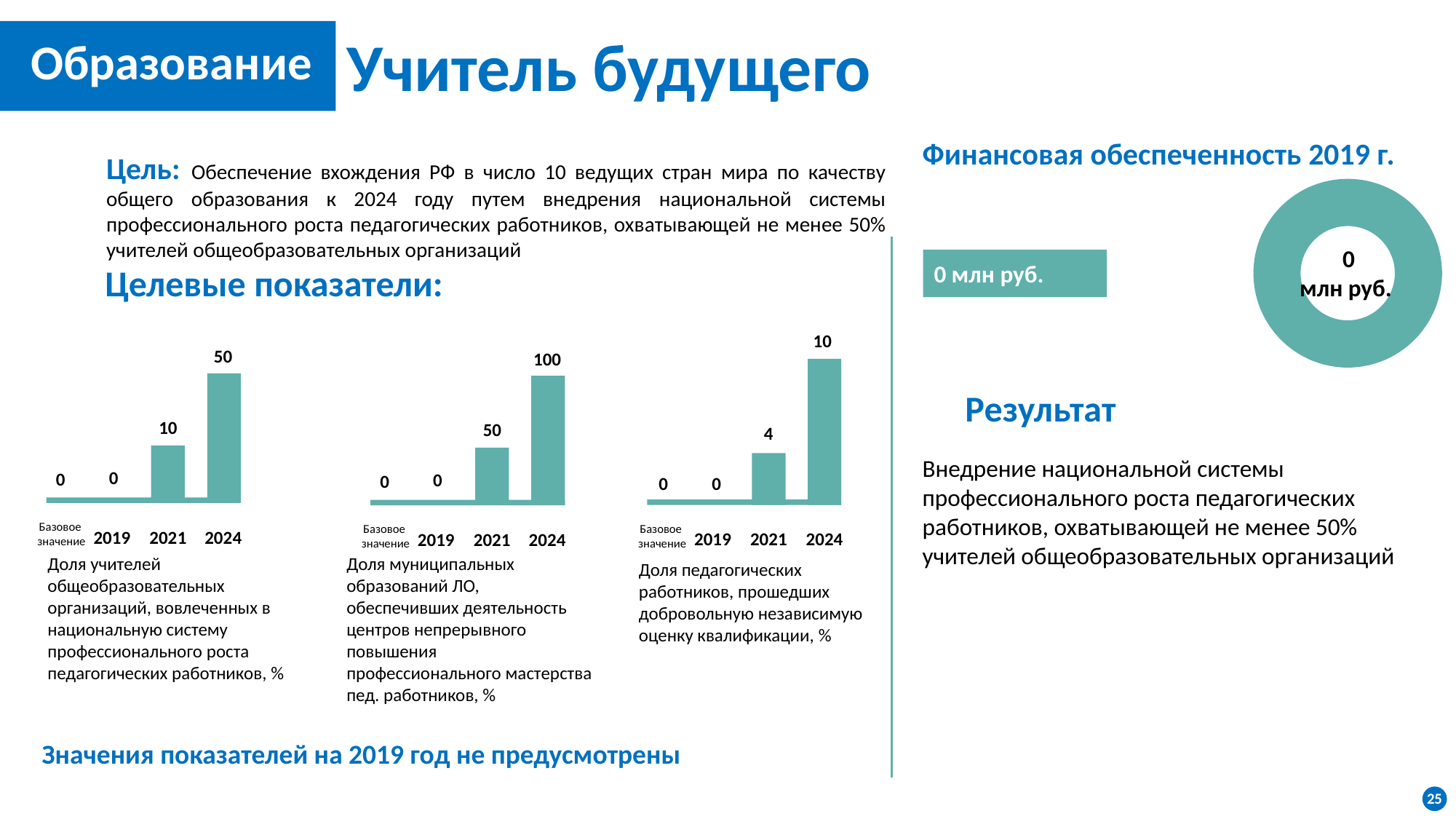
In the middle bar chart, what is the value for 2021? 50 In the left bar chart (Доля учителей общеобразовательных организаций, вовлеченных в национальную систему профессионального роста), what is the value for 2024? 50 What value is shown in the centre of the donut chart under Финансовая обеспеченность 2019 г.? 0 млн руб. In the left bar chart, what is the value for 2021? 10 In the right bar chart (Доля педагогических работников, прошедших добровольную независимую оценку квалификации), what is the value for 2021? 4 In the middle bar chart, what is the difference between the 2024 and 2021 values? 50 Do the values in the middle bar chart rise or fall from Базовое значение to 2024? rise In the left bar chart, what is the difference between the 2024 and 2021 values? 40 In the middle bar chart (Доля муниципальных образований ЛО), what is the value for 2024? 100 In the right bar chart, which is larger: the value for 2024 or the value for 2021? 2024 In the right bar chart, which year has the highest value? 2024 How many categories are shown on the x axis of the left bar chart? 4